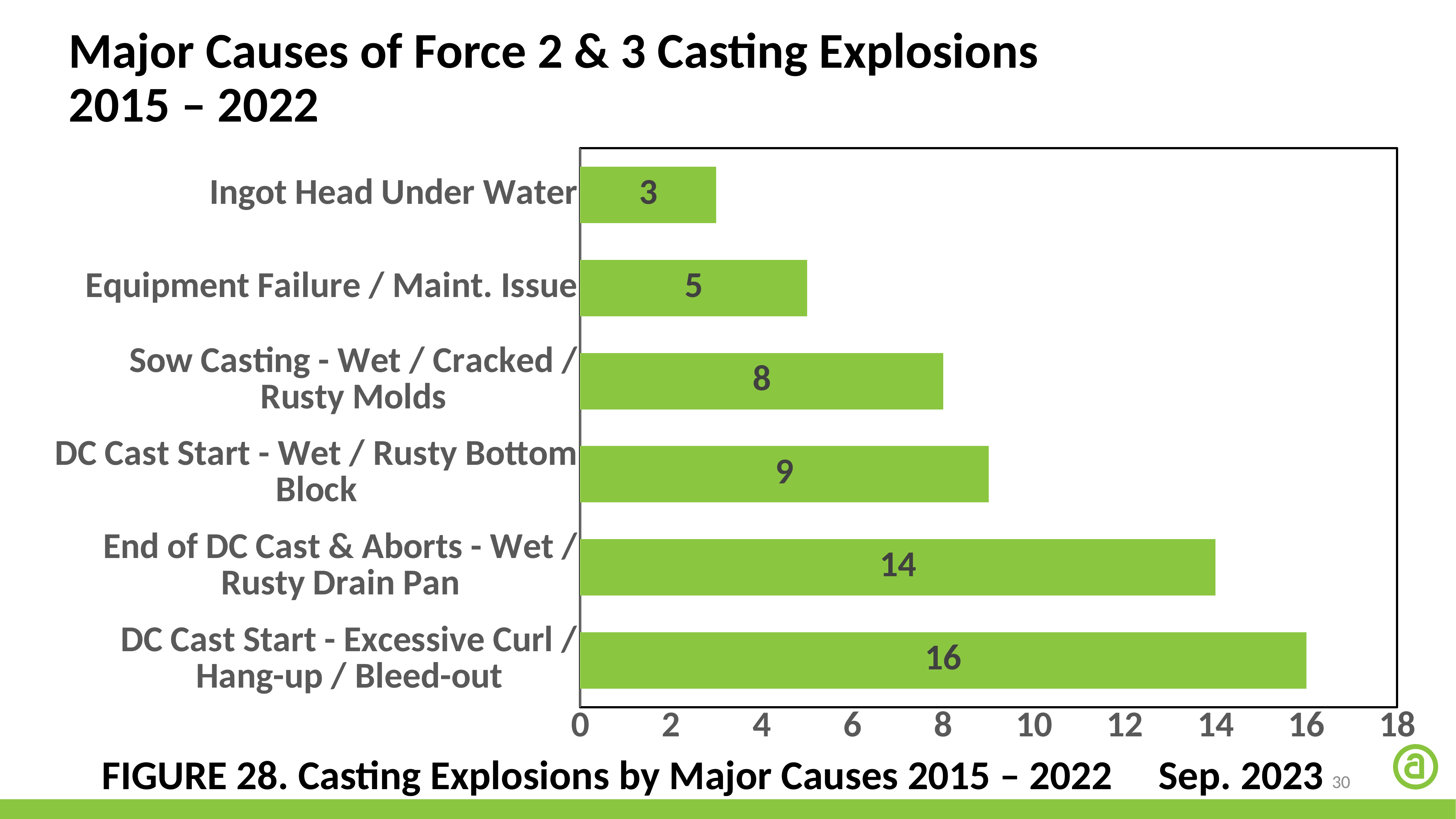
What is the difference between the values for DC Cast Start - Excessive Curl / Hang-up / Bleed-out and End of DC Cast & Aborts - Wet / Rusty Drain Pan? 2 What is the value for Equipment Failure / Maint. Issue? 5 What kind of chart is shown on the slide? bar chart What is the value for Sow Casting - Wet / Cracked / Rusty Molds? 8 What is the title of the slide? Major Causes of Force 2 & 3 Casting Explosions 2015 – 2022 What is the value for End of DC Cast & Aborts - Wet / Rusty Drain Pan? 14 Which cause has the lowest value? Ingot Head Under Water Which cause has the highest value? DC Cast Start - Excessive Curl / Hang-up / Bleed-out How many causes are shown in the chart? 6 Which is larger: the value for DC Cast Start - Wet / Rusty Bottom Block or the value for Sow Casting - Wet / Cracked / Rusty Molds? DC Cast Start - Wet / Rusty Bottom Block What is the value for Ingot Head Under Water? 3 Is the value for End of DC Cast & Aborts - Wet / Rusty Drain Pan greater or less than 10? greater